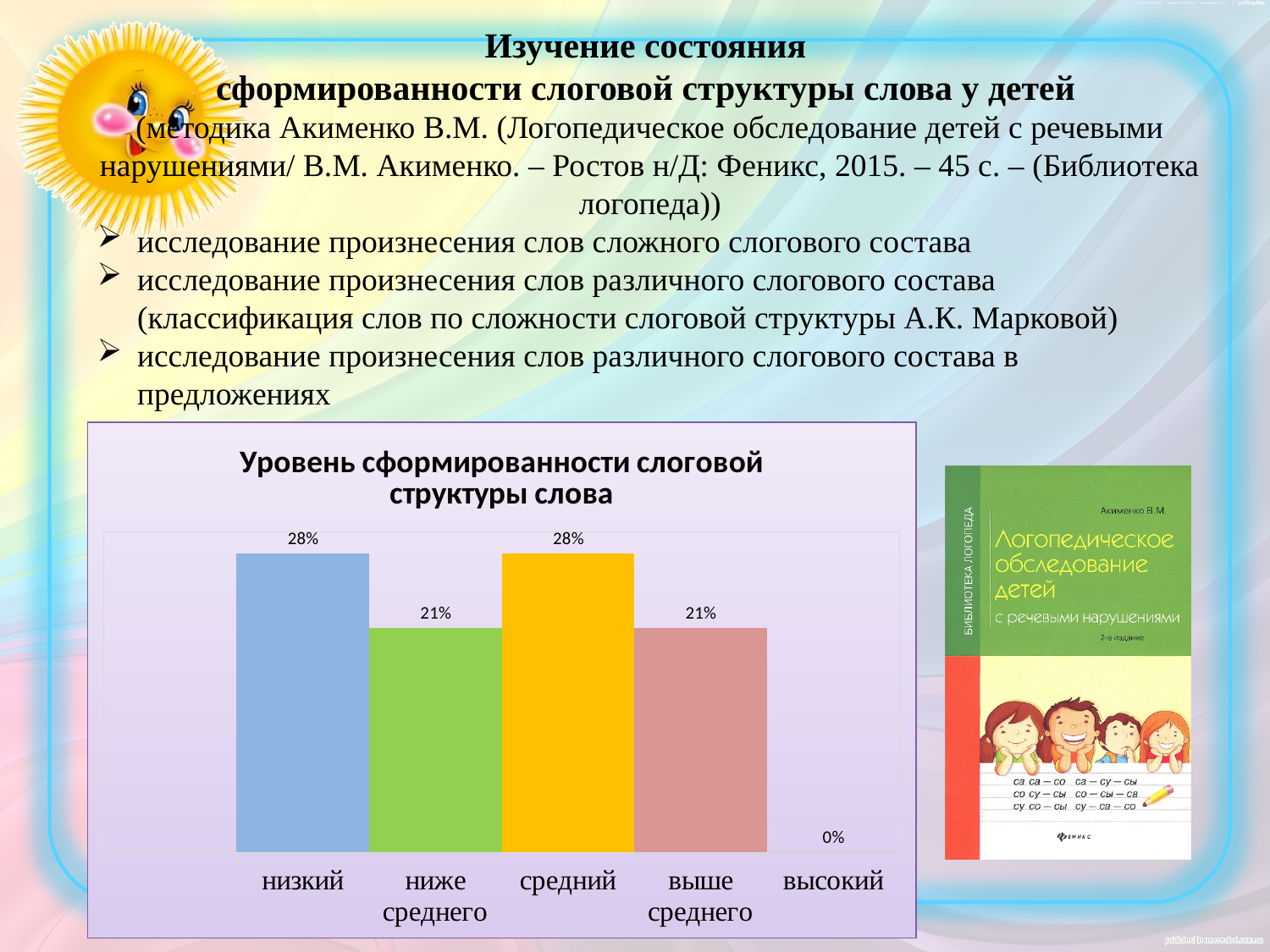
What kind of chart is shown on the slide? bar chart How many categories are shown on the x axis of the chart? 5 What is the value for «средний» in the chart? 28% Which is larger in the chart: the value for «выше среднего» or the value for «высокий»? выше среднего What is the value for «выше среднего» in the chart? 21% Which is larger in the chart: the value for «низкий» or the value for «ниже среднего»? низкий What is the difference between the values for «средний» and «выше среднего» in the chart? 7% What is the value for «высокий» in the chart? 0% What is the value for the category «низкий» in the chart «Уровень сформированности слоговой структуры слова»? 28% What is the title of the chart on the slide? Уровень сформированности слоговой структуры слова What is the value for «ниже среднего» in the chart? 21% Which category has the lowest value in the chart? высокий